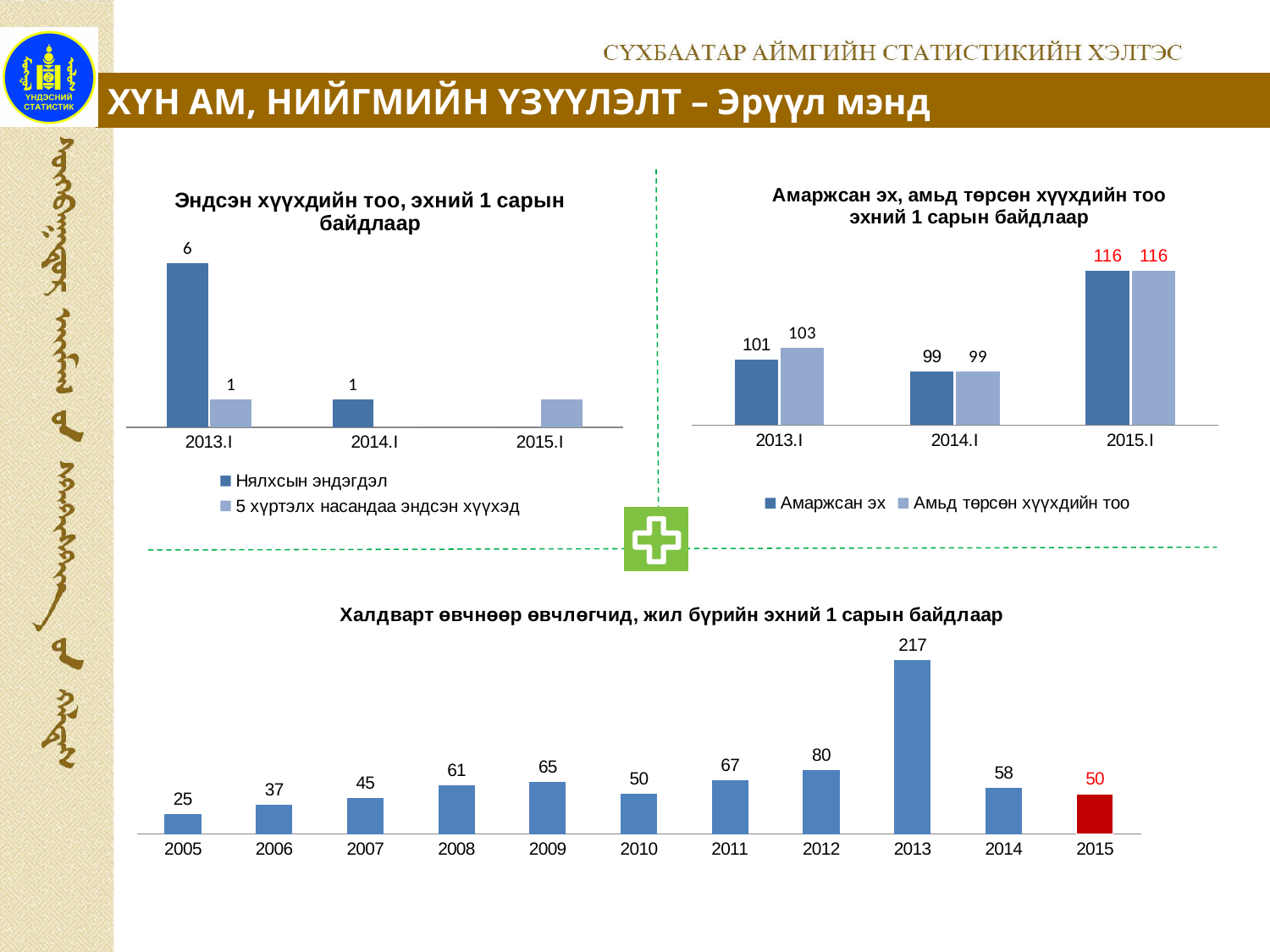
In the bottom chart 'Халдварт өвчнөөр өвчлөгчид, жил бүрийн эхний 1 сарын байдлаар', which year has the highest value? 2013 In the top-right chart 'Амаржсан эх, амьд төрсөн хүүхдийн тоо эхний 1 сарын байдлаар', what is the value of 'Амаржсан эх' for 2015.I? 116 In the bottom chart 'Халдварт өвчнөөр өвчлөгчид, жил бүрийн эхний 1 сарын байдлаар', which is larger, the value for 2008 or the value for 2010? 2008 In the bottom chart 'Халдварт өвчнөөр өвчлөгчид, жил бүрийн эхний 1 сарын байдлаар', how many years are shown on the x axis? 11 In the bottom chart 'Халдварт өвчнөөр өвчлөгчид, жил бүрийн эхний 1 сарын байдлаар', what is the value for 2013? 217 In the top-left chart 'Эндсэн хүүхдийн тоо, эхний 1 сарын байдлаар', what is the value of 'Нялхсын эндэгдэл' for 2013.I? 6 In the bottom chart 'Халдварт өвчнөөр өвчлөгчид, жил бүрийн эхний 1 сарын байдлаар', which year has the lowest value? 2005 In the bottom chart 'Халдварт өвчнөөр өвчлөгчид, жил бүрийн эхний 1 сарын байдлаар', what is the difference between the values for 2013 and 2014? 159 In the top-right chart 'Амаржсан эх, амьд төрсөн хүүхдийн тоо эхний 1 сарын байдлаар', how many series does the legend list? 2 In the top-right chart 'Амаржсан эх, амьд төрсөн хүүхдийн тоо эхний 1 сарын байдлаар', what is the value of 'Амьд төрсөн хүүхдийн тоо' for 2013.I? 103 What kind of chart is the top-left chart 'Эндсэн хүүхдийн тоо, эхний 1 сарын байдлаар'? Bar chart In the top-right chart 'Амаржсан эх, амьд төрсөн хүүхдийн тоо эхний 1 сарын байдлаар', what is the difference between 'Амьд төрсөн хүүхдийн тоо' and 'Амаржсан эх' for 2013.I? 2